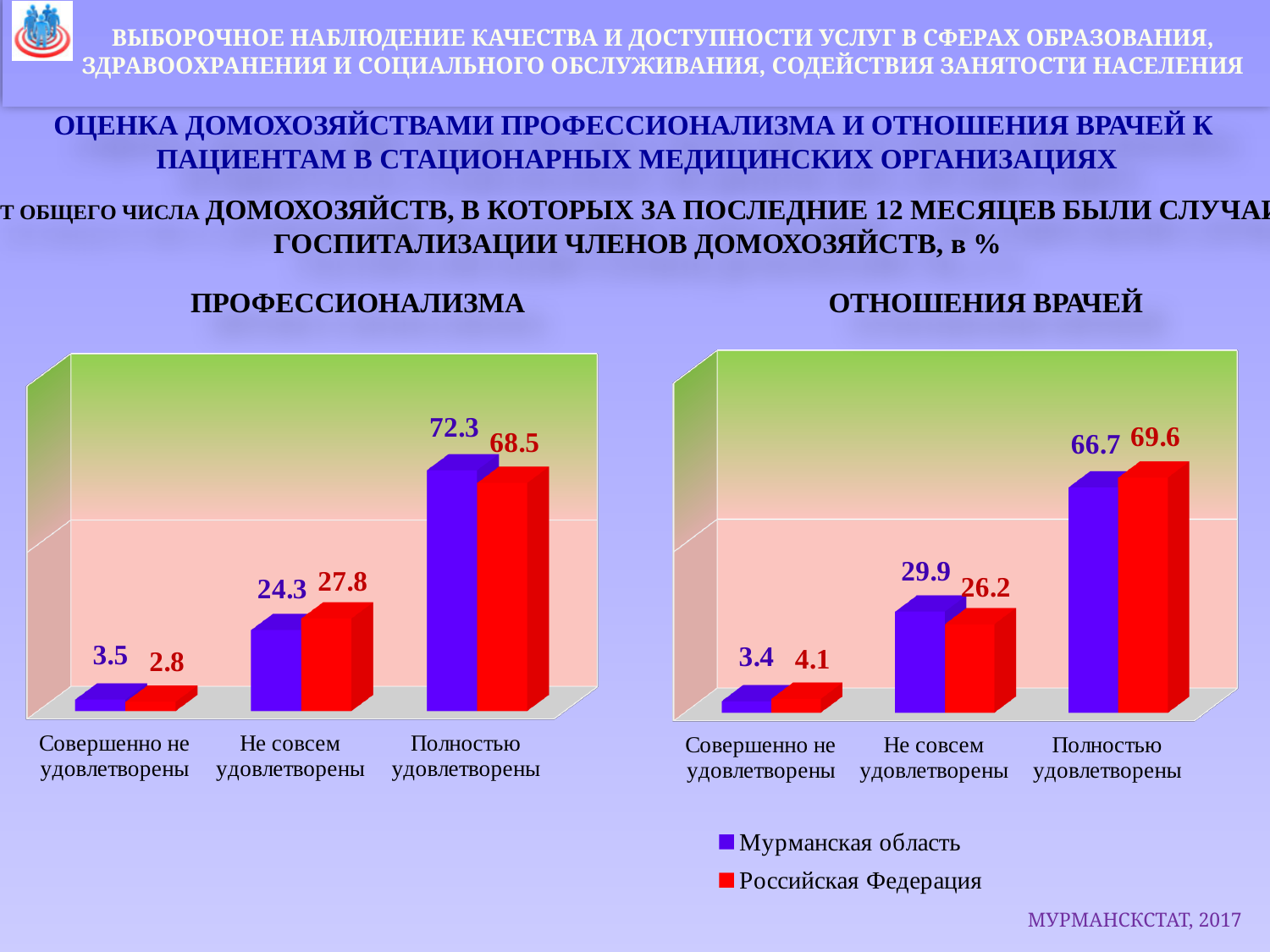
What kind of chart is the chart titled «ОТНОШЕНИЯ ВРАЧЕЙ»? Bar chart In the chart titled «ОТНОШЕНИЯ ВРАЧЕЙ», what is the value for Мурманская область in the category «Не совсем удовлетворены»? 29.9 How many series does the legend list for the charts on the slide? 2 In the chart titled «ПРОФЕССИОНАЛИЗМА», which category has the highest value for Мурманская область? Полностью удовлетворены In the chart titled «ОТНОШЕНИЯ ВРАЧЕЙ», which category has the lowest value for Российская Федерация? Совершенно не удовлетворены In the chart titled «ОТНОШЕНИЯ ВРАЧЕЙ», what is the difference between the Мурманская область and Российская Федерация values in the category «Не совсем удовлетворены»? 3.7 In the chart titled «ОТНОШЕНИЯ ВРАЧЕЙ», which is larger in the category «Полностью удовлетворены»: Мурманская область or Российская Федерация? Российская Федерация In the chart titled «ОТНОШЕНИЯ ВРАЧЕЙ», what is the value for Российская Федерация in the category «Совершенно не удовлетворены»? 4.1 In the chart titled «ПРОФЕССИОНАЛИЗМА», what is the difference between the Мурманская область and Российская Федерация values in the category «Полностью удовлетворены»? 3.8 In the chart titled «ПРОФЕССИОНАЛИЗМА», what is the value for Российская Федерация in the category «Не совсем удовлетворены»? 27.8 How many categories are shown on the x axis of the chart titled «ПРОФЕССИОНАЛИЗМА»? 3 In the chart titled «ПРОФЕССИОНАЛИЗМА», what is the value for Мурманская область in the category «Полностью удовлетворены»? 72.3